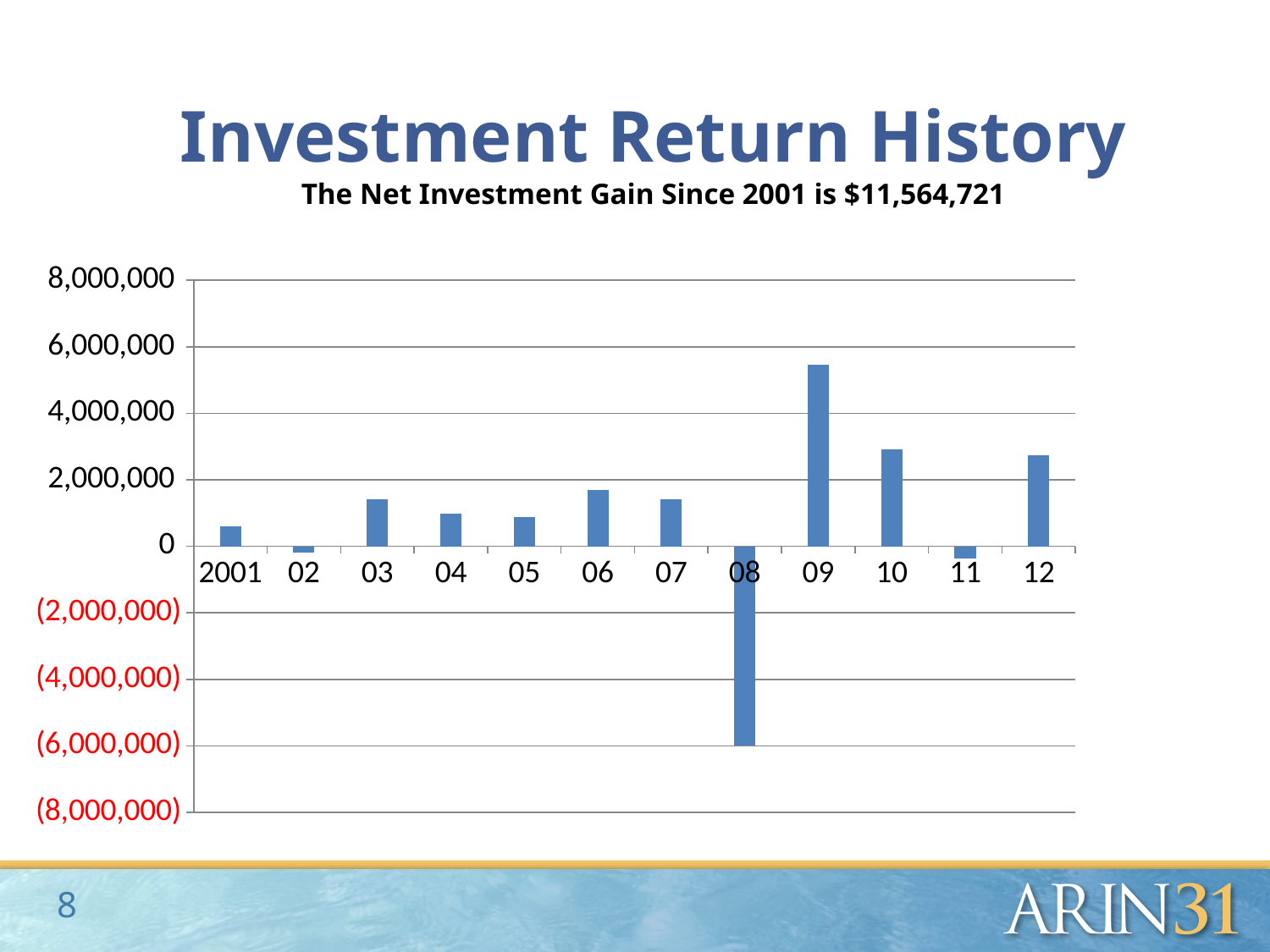
How many years in the chart show a negative investment return? 3 How many years are plotted on the x axis of the chart? 12 What kind of chart is shown on the slide? bar chart Which year has the larger value, 06 or 04? 06 According to the slide, what is the net investment gain since 2001? $11,564,721 Is the value for 06 greater or less than 2,000,000? less Is the value for 08 greater or less than (4,000,000)? less Which year has the highest investment return in the chart? 09 Which year has the lowest investment return in the chart? 08 Is the value for 09 greater or less than 4,000,000? greater Which year has the larger value, 09 or 10? 09